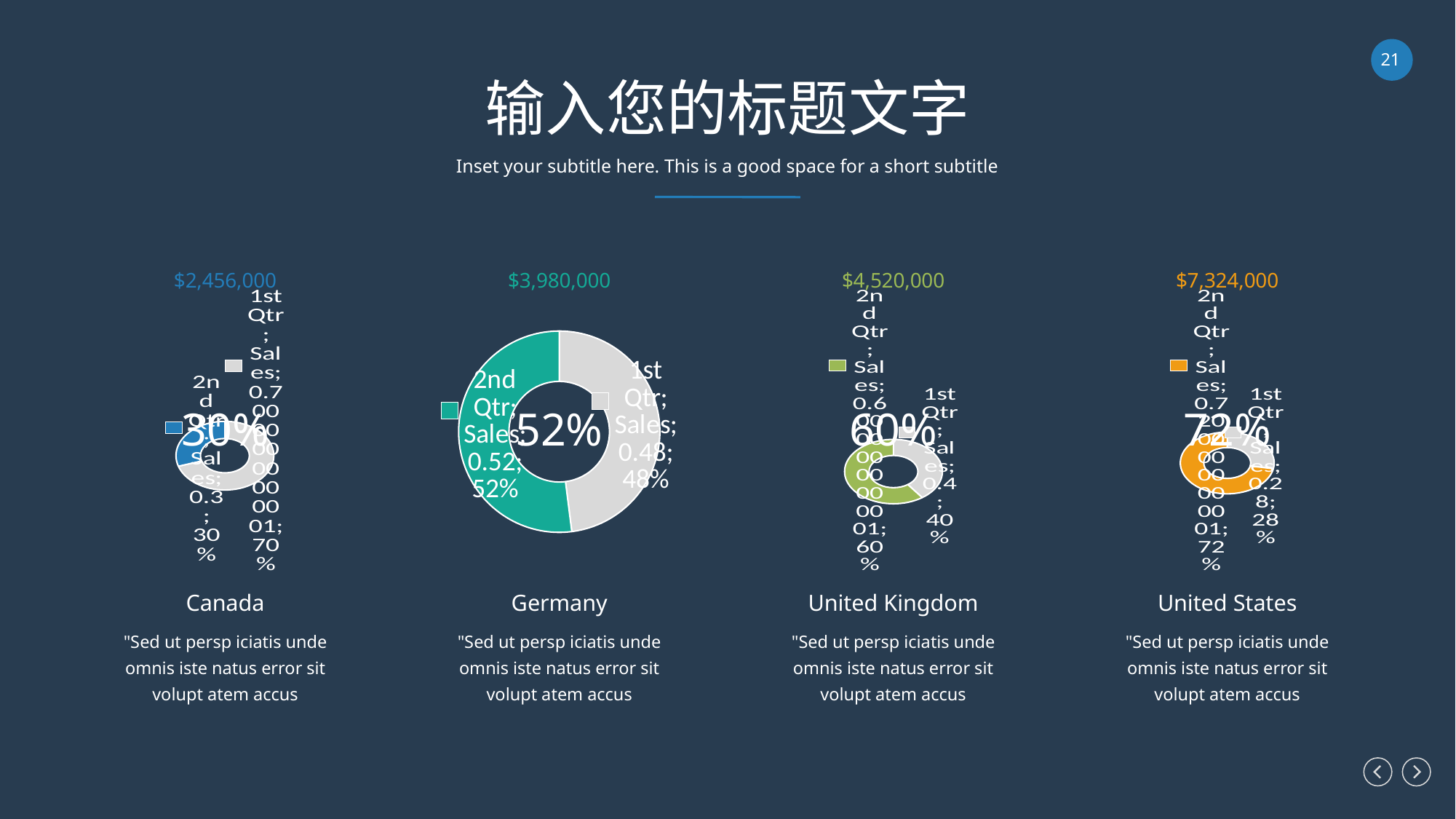
What type of chart is used for each of the four countries on the slide? Doughnut chart In the United States chart, which slice is larger, 1st Qtr or 2nd Qtr? 2nd Qtr In the United Kingdom chart, what percentage is shown for 2nd Qtr? 60% In the United Kingdom chart, what is the difference between the 2nd Qtr and 1st Qtr percentages? 20% How many slices does each doughnut chart on the slide have? 2 In the Canada chart, which slice is larger, 1st Qtr or 2nd Qtr? 1st Qtr In the Germany chart, what percentage is shown for 2nd Qtr? 52% What is the large percentage displayed in the centre of the United States chart? 72% In the Germany chart, what percentage is shown for 1st Qtr? 48% What dollar figure is shown above the Germany chart? $3,980,000 In the United States chart, what percentage is shown for 1st Qtr? 28% In the Canada chart, what percentage is shown for 1st Qtr? 70%